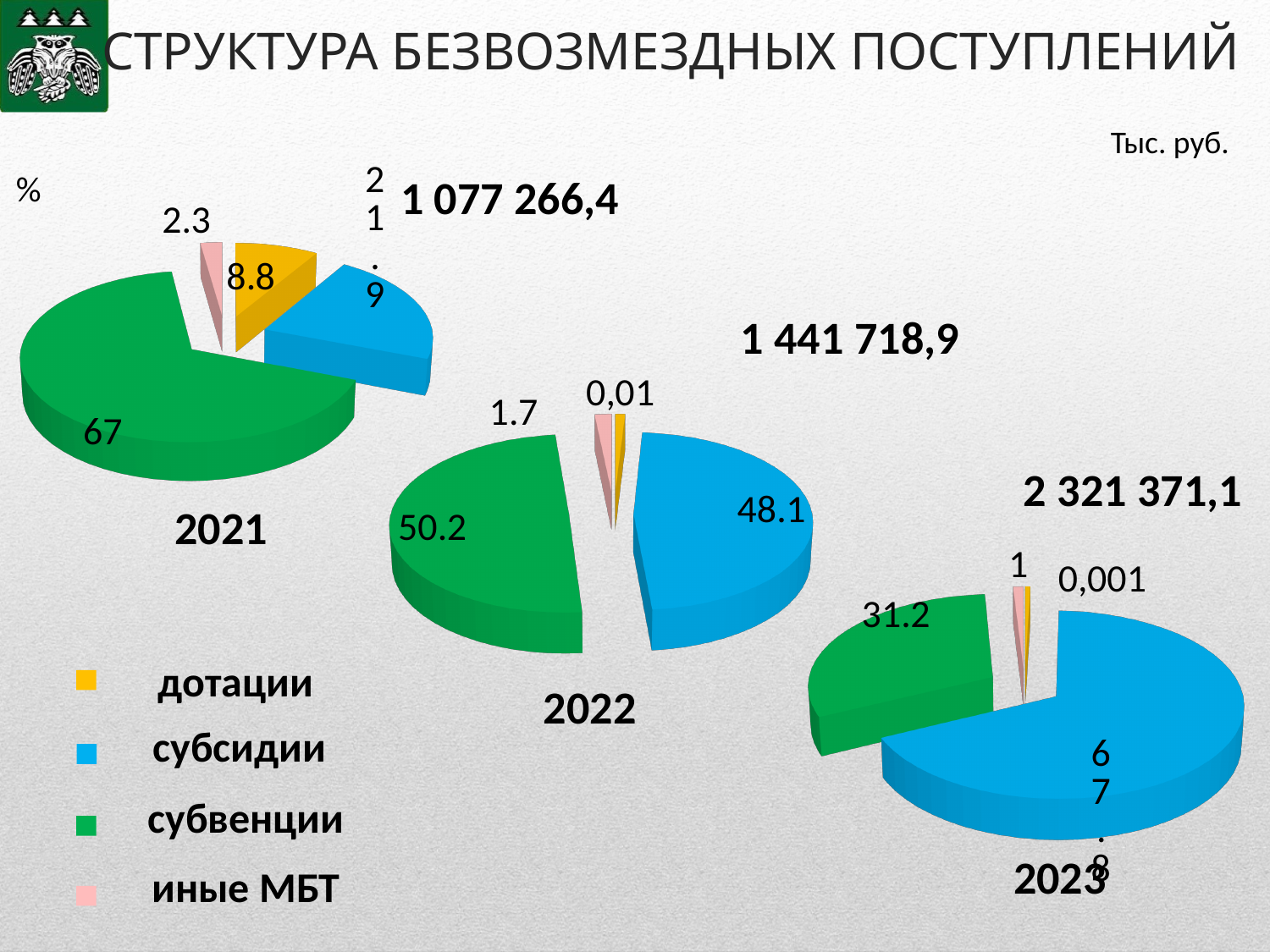
In the 2021 pie chart, which category has the largest slice? субвенции In the 2022 pie chart, what percentage is shown for субсидии? 48.1 How many categories does the legend list? 4 In the 2022 pie chart, what value is shown for дотации? 0,01 In the 2021 pie chart, what is the difference between the субвенции and дотации percentages? 58.2 In the 2023 pie chart, what value is shown for иные МБТ? 1 What type of chart is used for each year on the slide? pie chart What total amount (тыс. руб.) is shown above the 2022 pie chart? 1 441 718,9 In the 2021 pie chart, what percentage is shown for субвенции? 67 In the 2023 pie chart, what percentage is shown for субвенции? 31.2 In the 2022 pie chart, which is larger, субвенции or субсидии? субвенции In the 2023 pie chart, which category has the smallest slice? дотации